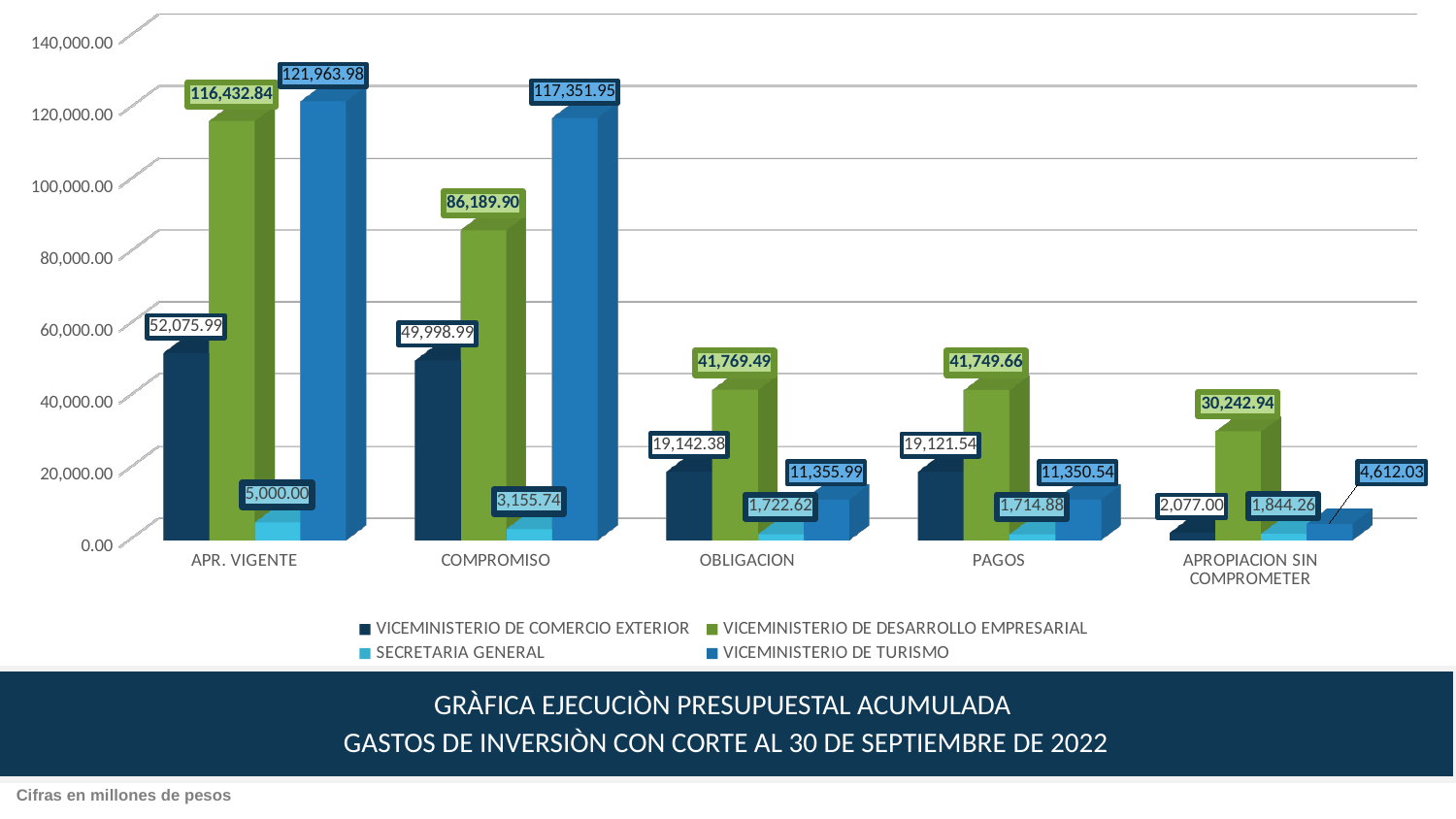
Which series has the highest value in the APR. VIGENTE category? VICEMINISTERIO DE TURISMO How many categories are shown on the x axis? 5 What is the value for VICEMINISTERIO DE DESARROLLO EMPRESARIAL in the COMPROMISO category? 86,189.90 What is the difference between the VICEMINISTERIO DE TURISMO values for APR. VIGENTE and COMPROMISO? 4,612.03 What is the value for VICEMINISTERIO DE COMERCIO EXTERIOR in the APROPIACION SIN COMPROMETER category? 2,077.00 How many series does the legend list? 4 What is the value for VICEMINISTERIO DE TURISMO in the APR. VIGENTE category? 121,963.98 What is the value for SECRETARIA GENERAL in the PAGOS category? 1,714.88 In the OBLIGACION category, which is larger: VICEMINISTERIO DE COMERCIO EXTERIOR or VICEMINISTERIO DE TURISMO? VICEMINISTERIO DE COMERCIO EXTERIOR What kind of chart is shown on the slide? Bar chart According to the note below the chart, in what units are the figures expressed? Millones de pesos Which series has the lowest value in the OBLIGACION category? SECRETARIA GENERAL